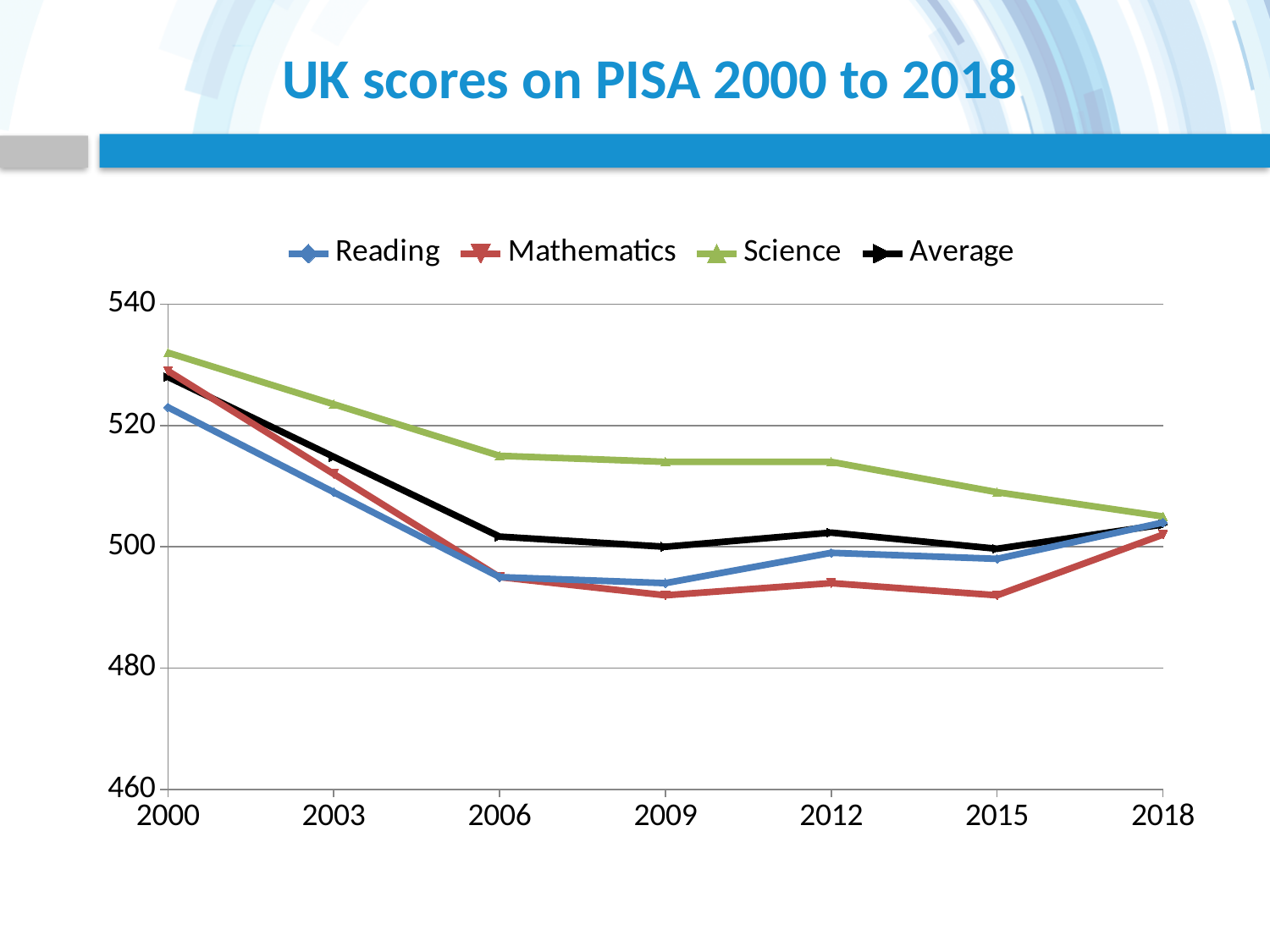
Is the Mathematics value for 2009 greater or less than 500? less Which series has the highest value in 2006? Science Which series has the lowest value in 2015? Mathematics Does the Science line rise or fall from 2000 to 2018? Fall In which year is the Science value highest? 2000 In 2000, which is larger: the Science value or the Reading value? Science Is the Science value for 2000 greater or less than 520? greater How many series does the legend list? 4 What is the title of the chart? UK scores on PISA 2000 to 2018 How many years are plotted along the x axis? 7 Is the Reading value for 2003 greater or less than 520? less What kind of chart is shown on the slide? Line chart